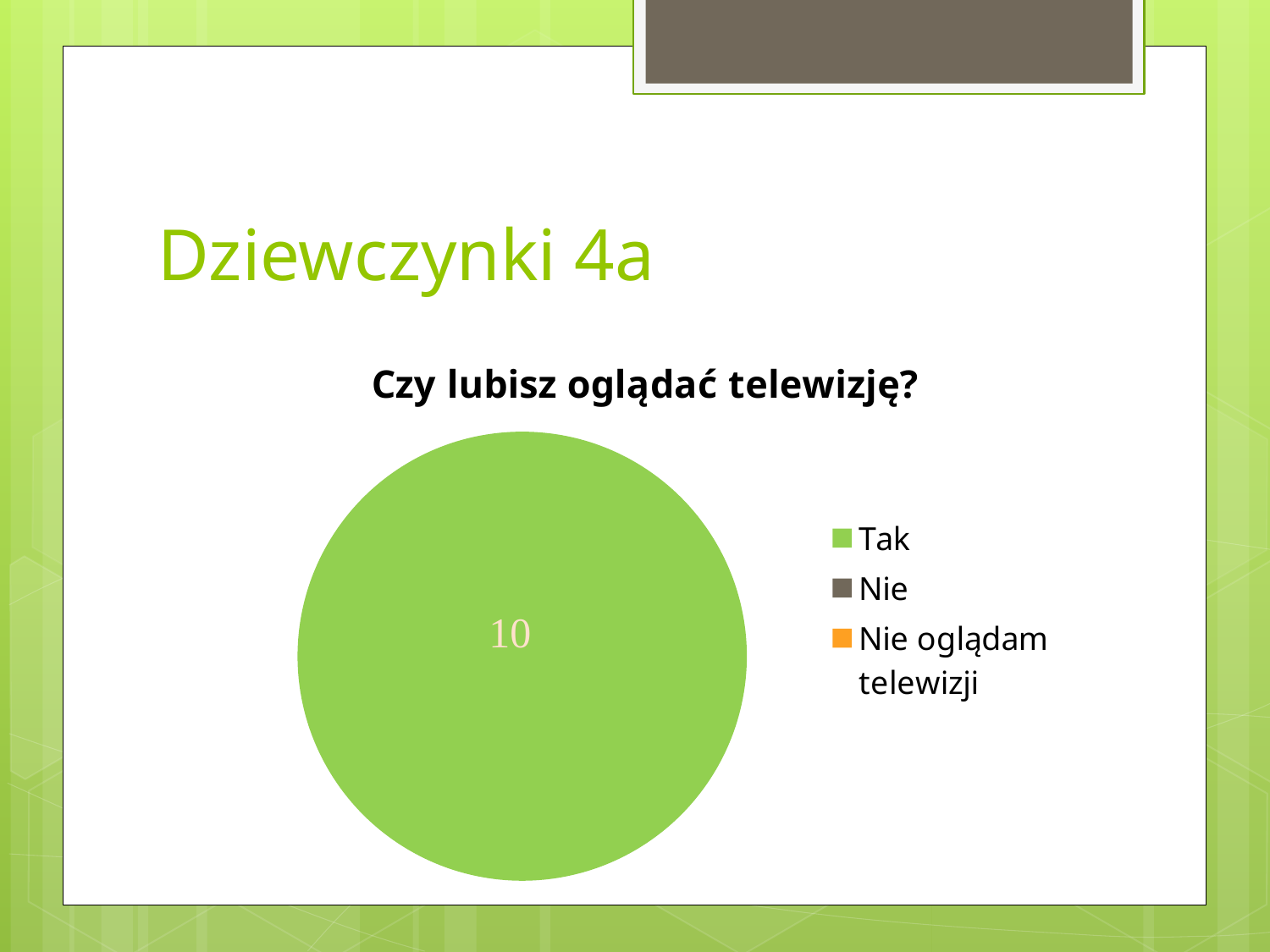
What type of chart is shown on the slide? pie chart How many entries does the chart legend list? 3 Which legend entry is shown in green? Tak What is the title of the chart? Czy lubisz oglądać telewizję? Is the value for "Tak" greater or less than 5? greater What value is shown for the "Tak" slice of the pie chart? 10 What share of the pie does the "Tak" slice take up? 100% How many slices are visible in the pie chart? 1 Which category has the largest slice in the pie chart? Tak